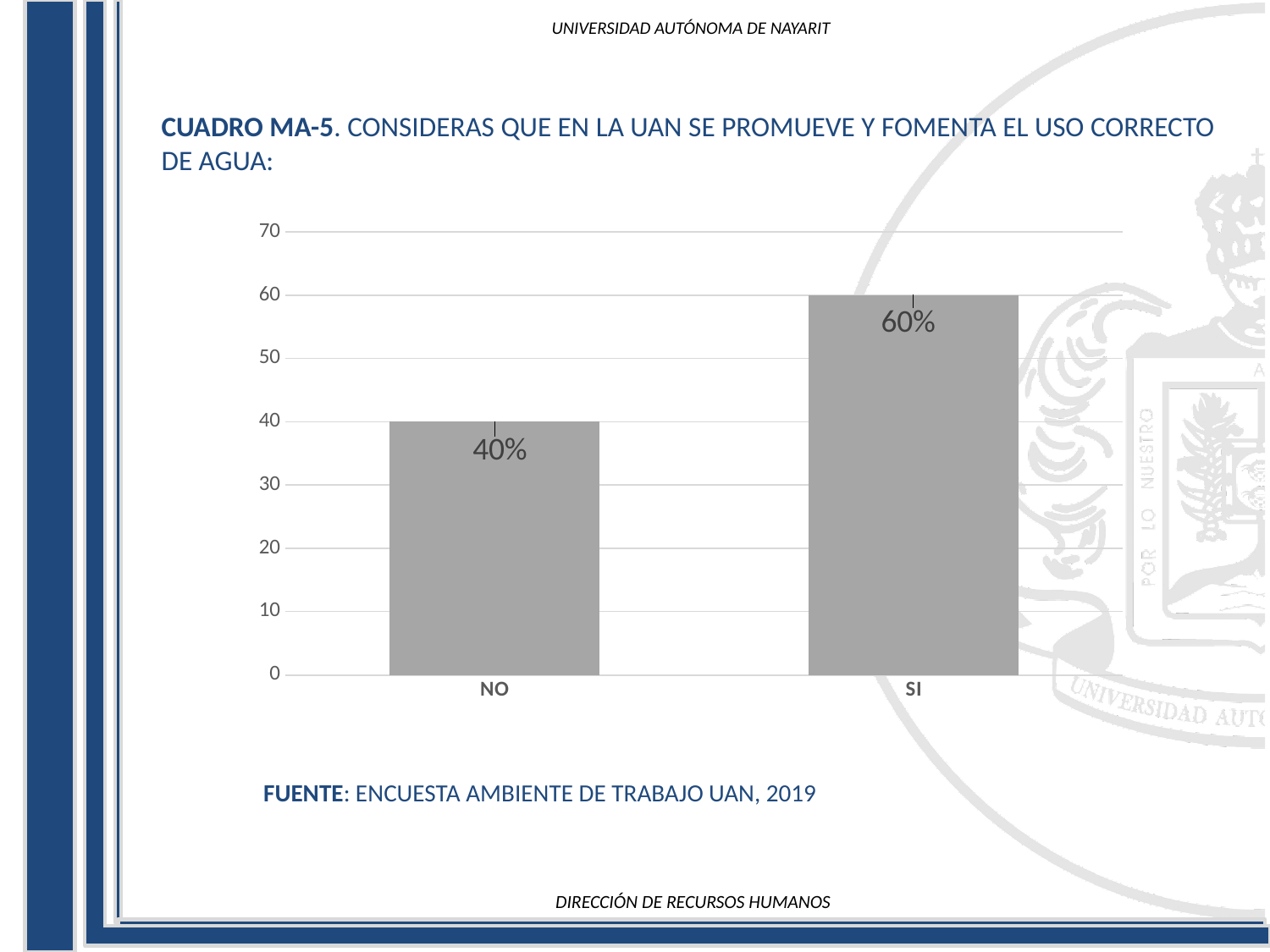
Which category has the highest value? SI Is the value for NO greater or less than 50? less What is the value for NO? 40% Is the value for SI greater or less than 50? greater What is the value for SI? 60% How many categories are shown on the x axis? 2 Which is larger, the value for NO or the value for SI? SI What is the highest value shown on the y axis? 70 What is the difference between the values for SI and NO? 20% Which category has the lowest value? NO What source is cited below the chart? ENCUESTA AMBIENTE DE TRABAJO UAN, 2019 What kind of chart is shown on the slide? bar chart